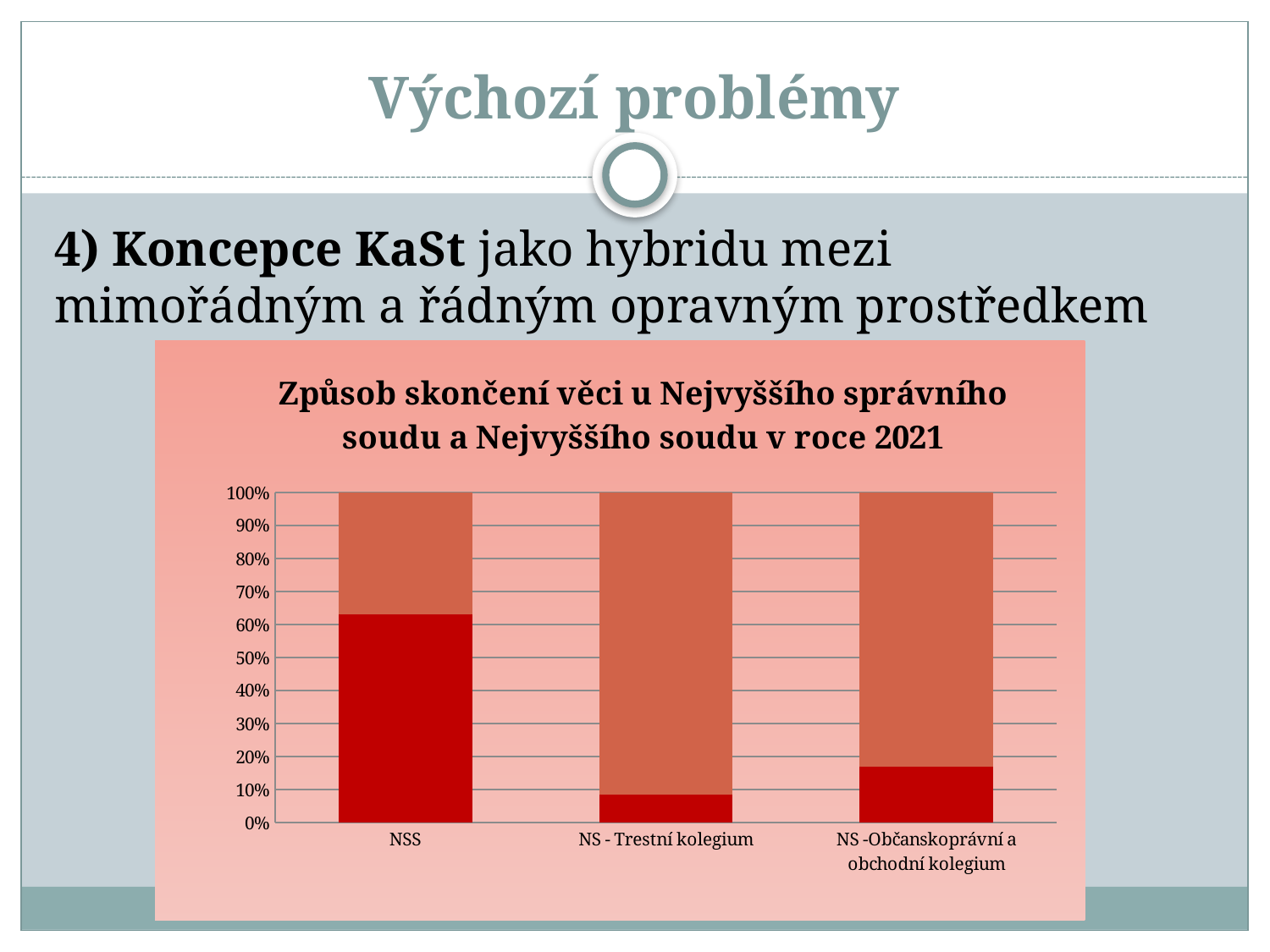
How many categories are shown along the x axis of the chart? 3 What is the highest value shown on the chart's y axis? 100% Is the dark red segment for NSS greater or less than 70%? less Is the dark red segment for NS - Občanskoprávní a obchodní kolegium greater or less than 20%? less What kind of chart is shown on the slide? stacked bar chart Which category has the smallest dark red (bottom) segment? NS - Trestní kolegium Is the dark red segment for NS - Trestní kolegium greater or less than 10%? less What is the title of the chart? Způsob skončení věci u Nejvyššího správního soudu a Nejvyššího soudu v roce 2021 Which has a larger dark red segment, NSS or NS - Občanskoprávní a obchodní kolegium? NSS Which category has the largest dark red (bottom) segment? NSS